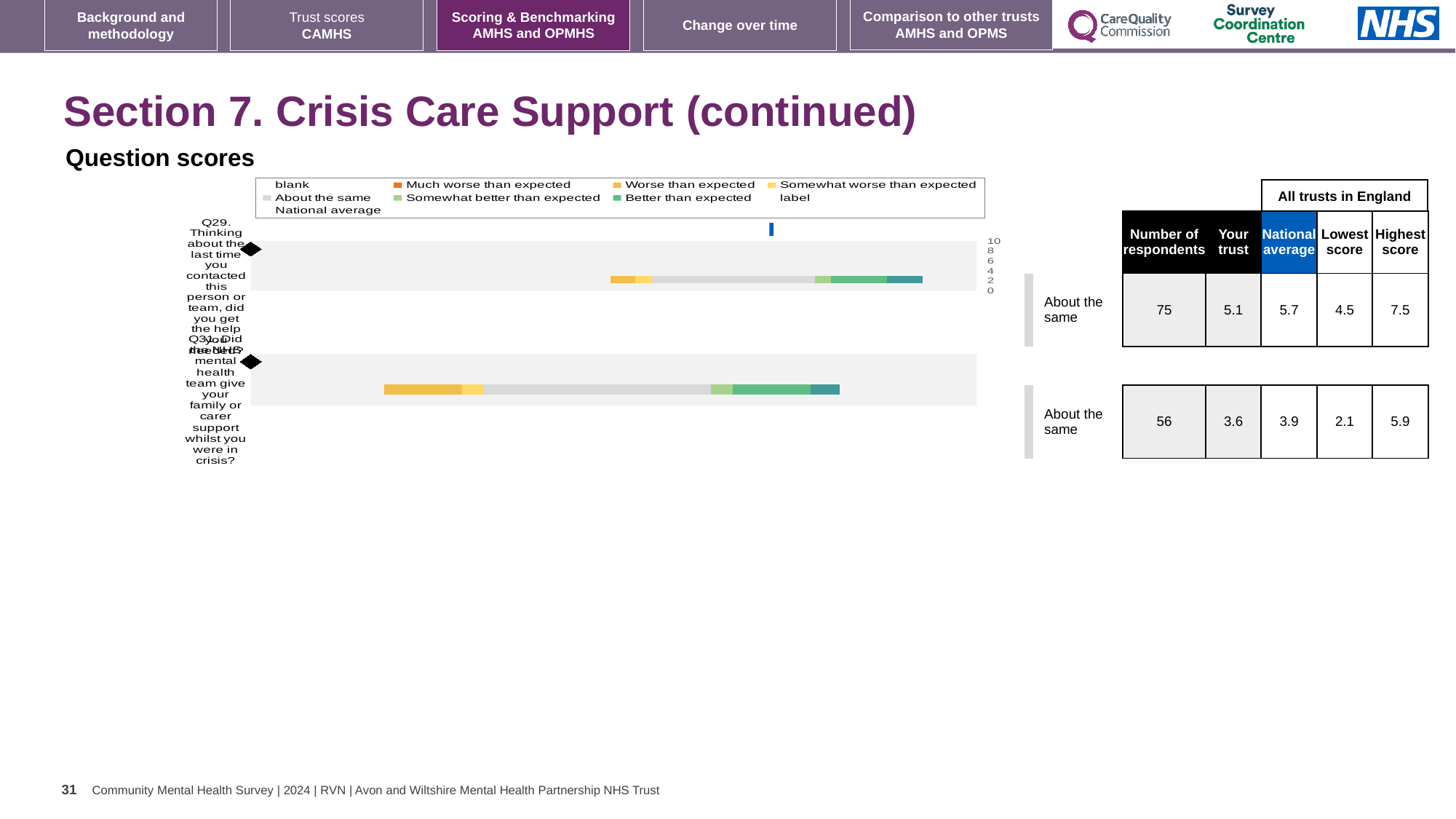
In the table, what is the difference between the highest score and the lowest score for Q31? 3.8 Which question has more respondents in the table, Q29 or Q31? Q29 In the table beside the chart, what is the highest score for Q29? 7.5 What colour is the legend marker for 'Much worse than expected' in the question scores chart? orange In the table beside the chart, what is the number of respondents for Q29? 75 What kind of chart is used to show the question scores on this slide? bar chart In the table beside the chart, what is the 'Your trust' score for Q31? 3.6 For Q29, which is larger in the table: the 'Your trust' score or the national average? National average In the table beside the chart, what is the national average for Q29? 5.7 How many entries does the legend of the question scores chart list? 9 What is the heading above the chart on this slide? Question scores How many questions are plotted as bars in the question scores chart? 2